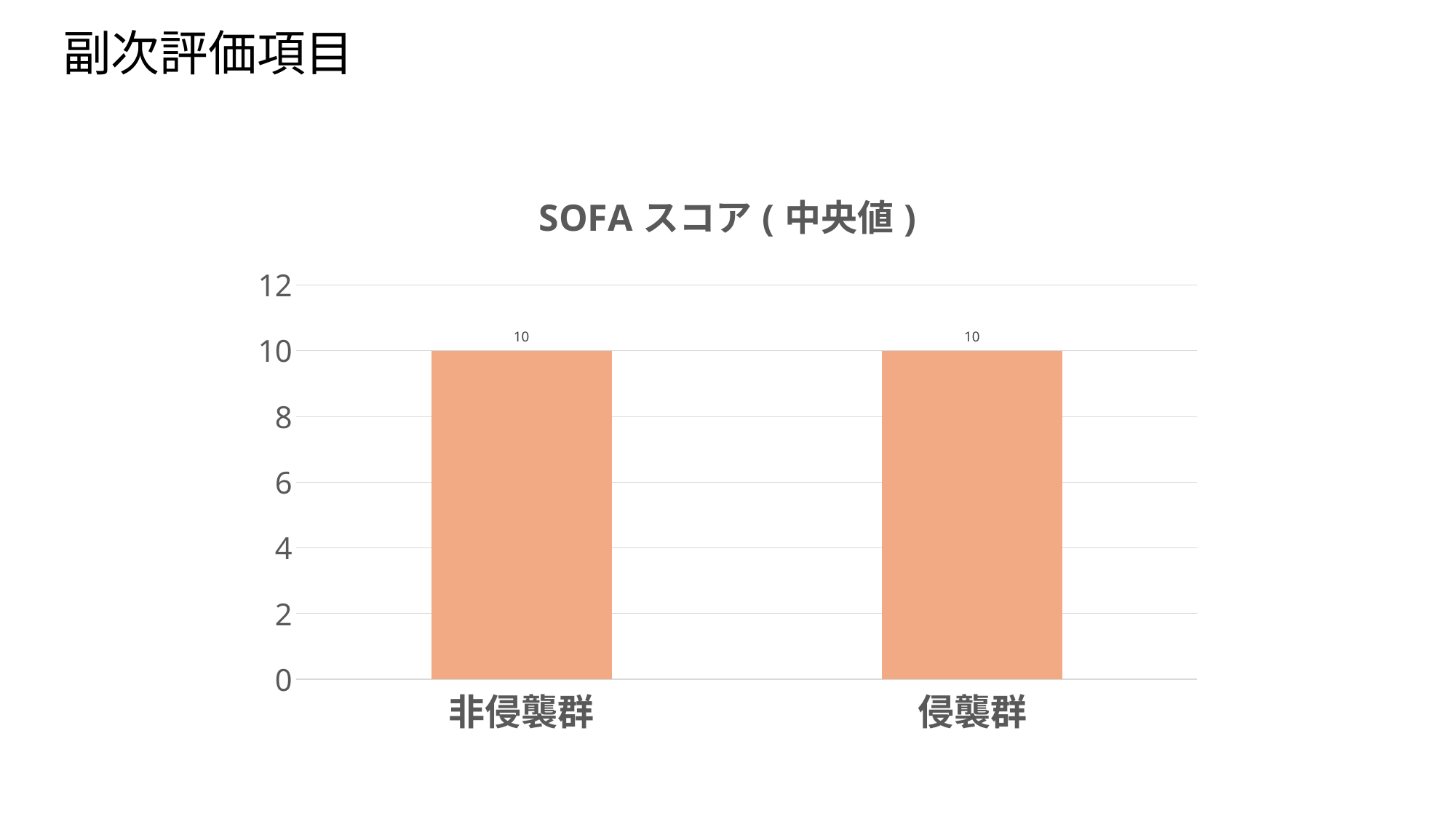
What is the difference between the values for 非侵襲群 and 侵襲群? 0 Is the value for 侵襲群 greater or less than 8? greater What is the value for 非侵襲群? 10 How many categories are shown on the x axis? 2 What kind of chart is shown on the slide? bar chart What is the title of the chart? SOFA スコア ( 中央値 ) What is the value for 侵襲群? 10 Is the value for 非侵襲群 greater or less than 12? less What is the highest value shown on the vertical axis? 12